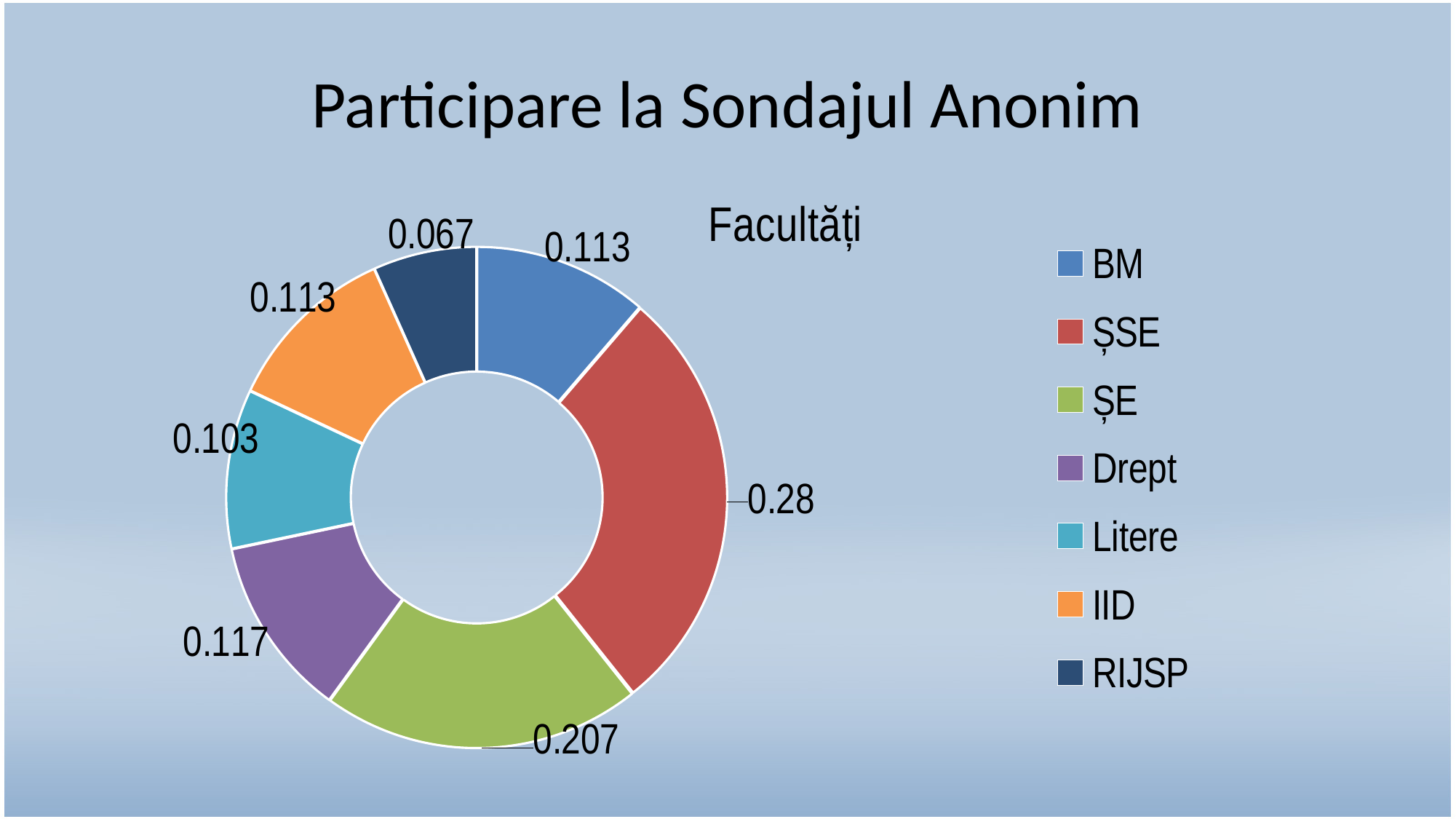
What is the value for ȘE? 0.207 What is the value for RIJSP? 0.067 Which colour represents IID in the chart? Orange What kind of chart is shown on the slide? Doughnut chart Which is larger, the value for Drept or the value for Litere? Drept Which faculty has the lowest value? RIJSP What is the difference between the values for ȘSE and ȘE? 0.073 What is the title of the chart? Facultăți What is the value for ȘSE? 0.28 How many faculties are shown in the chart? 7 What is the value for Litere? 0.103 Which faculty has the highest value? ȘSE